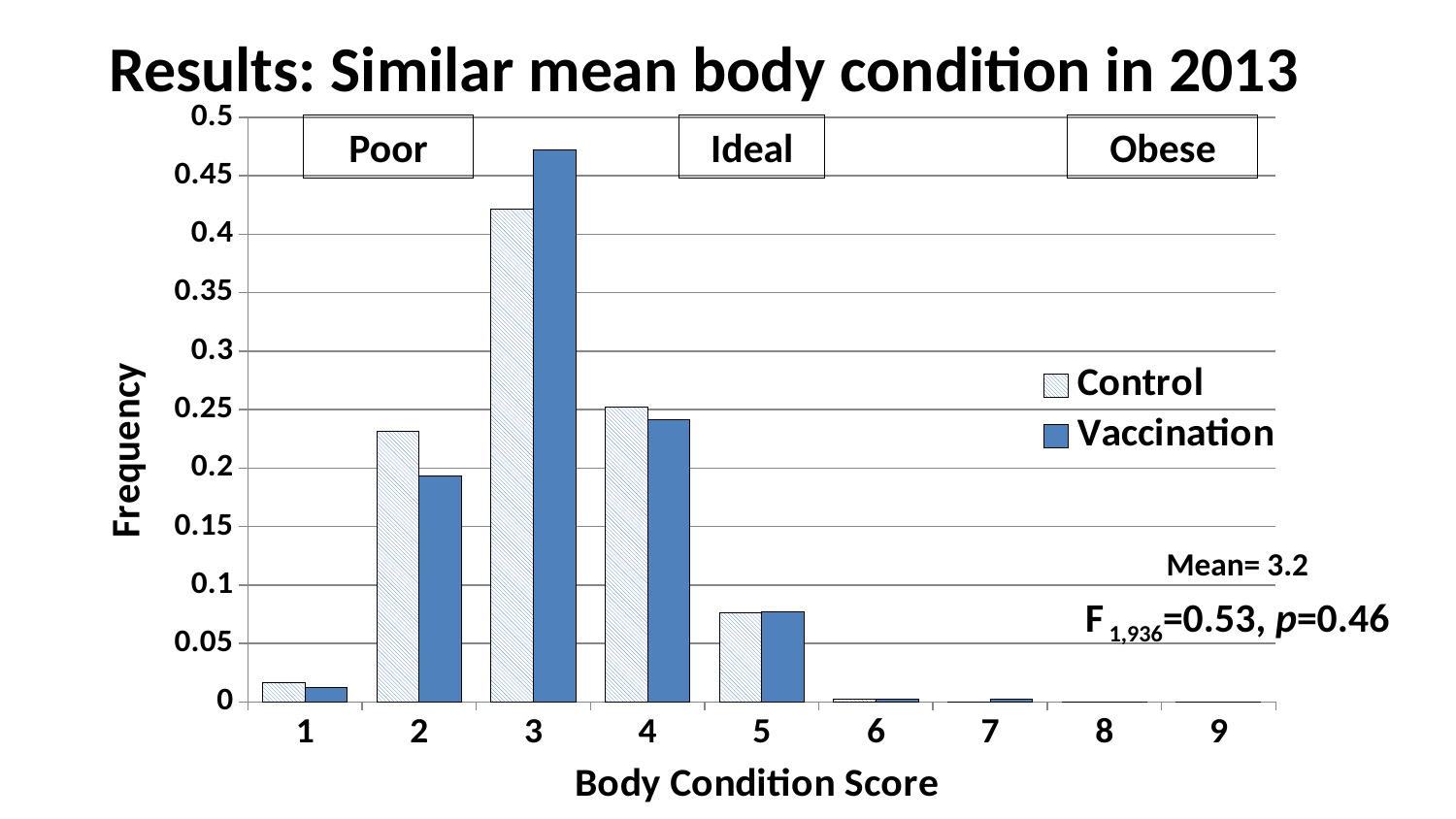
At body condition score 3, which series has the larger frequency, Control or Vaccination? Vaccination Is the Control frequency at body condition score 5 greater or less than 0.05? greater What kind of chart is shown on the slide? bar chart How many series does the legend list? 2 At body condition score 2, which series has the larger frequency, Control or Vaccination? Control How many body condition score categories are shown on the x axis? 9 What is the label of the y axis? Frequency Do the frequencies rise or fall as the body condition score increases from 3 to 9? fall Which body condition score has the highest frequency for the Vaccination series? 3 Which body condition score has the highest frequency for the Control series? 3 Is the Control frequency at body condition score 3 greater or less than 0.45? less Is the Vaccination frequency at body condition score 3 greater or less than 0.45? greater